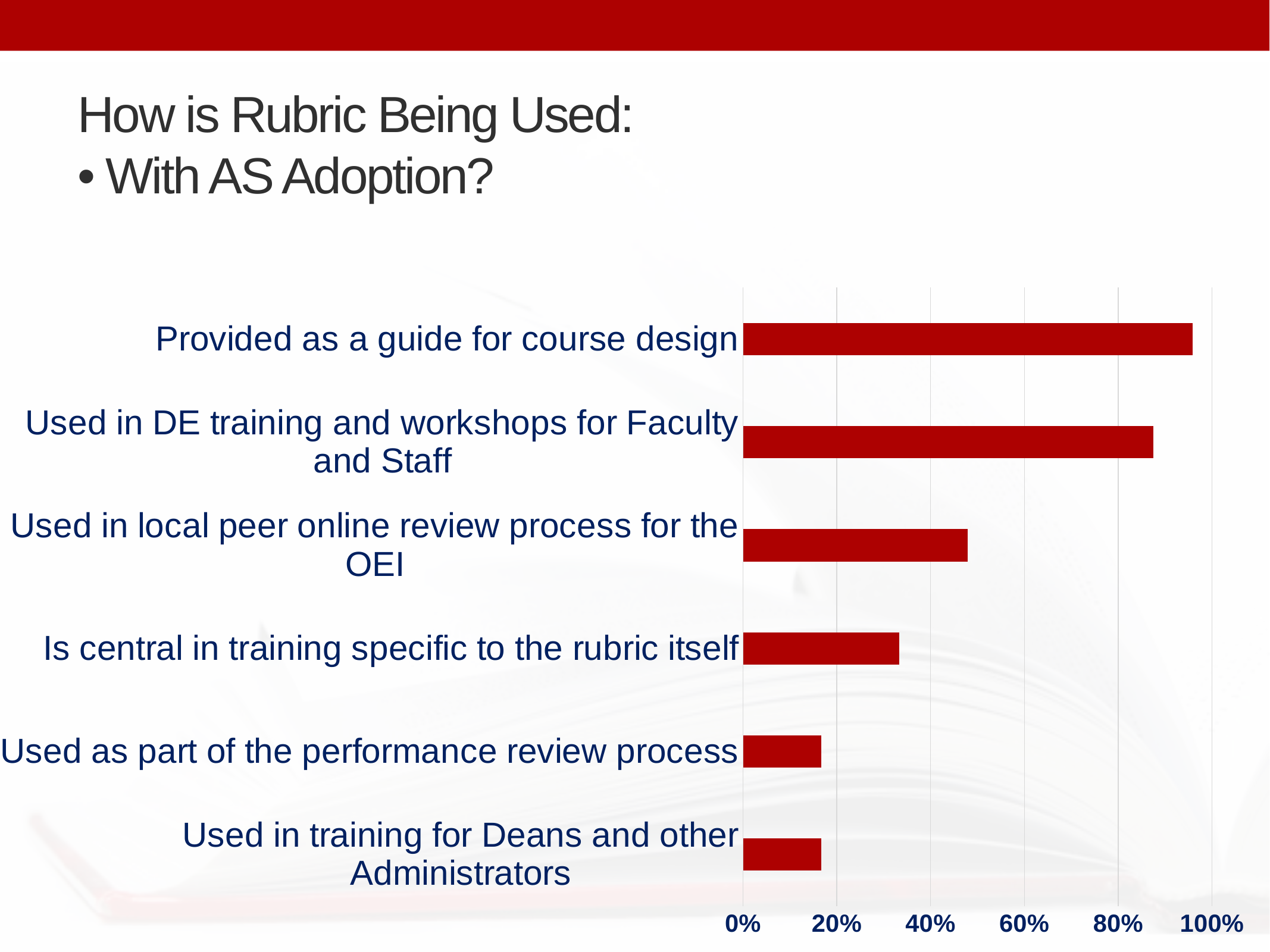
Is the value for "Used in training for Deans and other Administrators" greater or less than 40%? less Which is larger: the value for "Used in local peer online review process for the OEI" or the value for "Is central in training specific to the rubric itself"? Used in local peer online review process for the OEI Which category has the highest value in the chart? Provided as a guide for course design How many categories are plotted in the chart? 6 Is the value for "Used in DE training and workshops for Faculty and Staff" greater or less than 80%? greater Is the value for "Provided as a guide for course design" greater or less than 80%? greater Which is larger: the value for "Used in DE training and workshops for Faculty and Staff" or the value for "Used as part of the performance review process"? Used in DE training and workshops for Faculty and Staff What is the highest value shown on the chart's horizontal axis? 100% What kind of chart is shown on the slide? bar chart